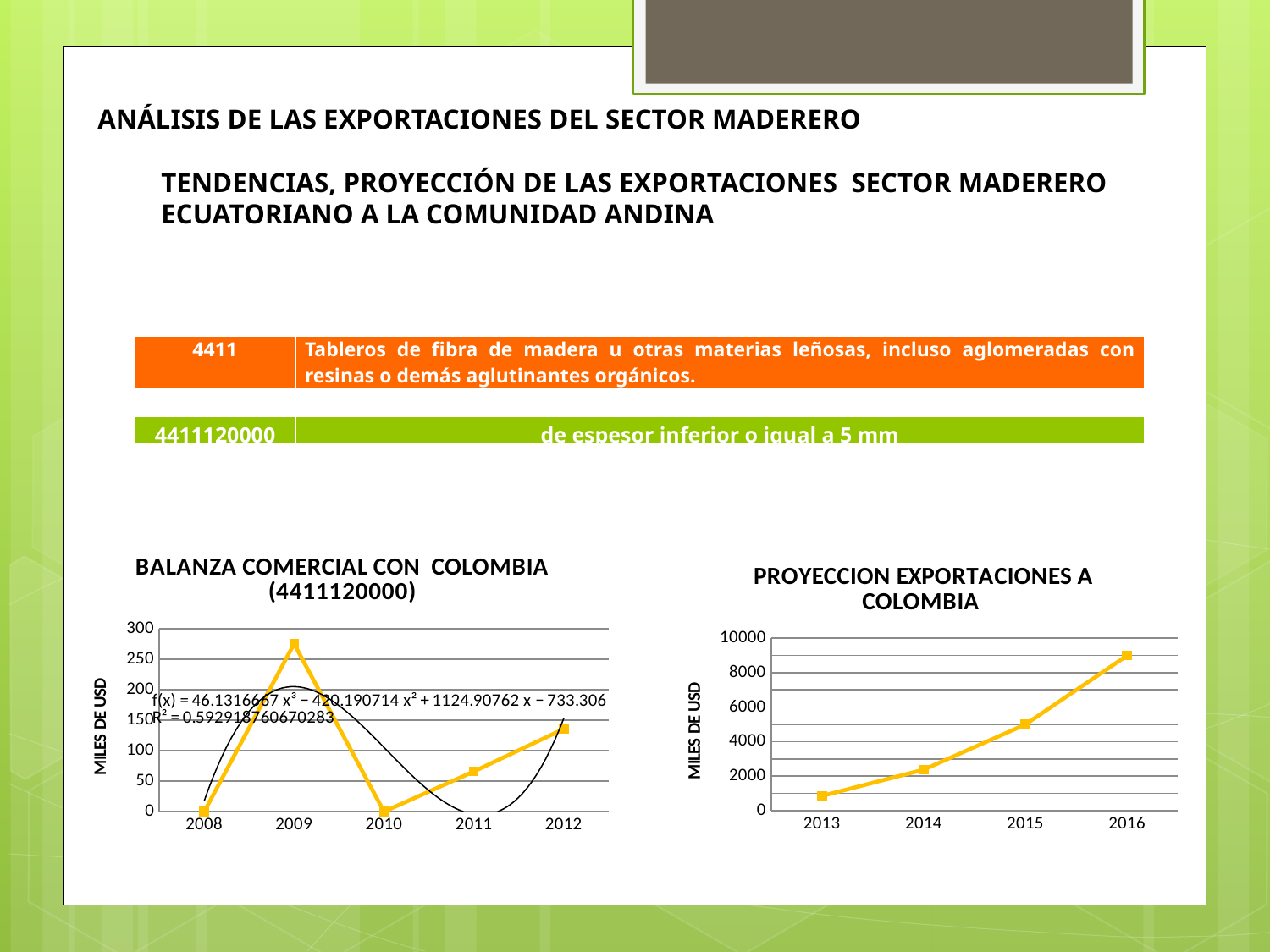
In the 'BALANZA COMERCIAL CON COLOMBIA (4411120000)' chart, how many years are shown on the x axis? 5 In the 'BALANZA COMERCIAL CON COLOMBIA (4411120000)' chart, is the value for 2009 greater or less than 250? greater In the 'PROYECCION EXPORTACIONES A COLOMBIA' chart, do the values rise or fall from 2013 to 2016? rise In the 'PROYECCION EXPORTACIONES A COLOMBIA' chart, which year has the lowest value? 2013 In the 'PROYECCION EXPORTACIONES A COLOMBIA' chart, how many years are shown on the x axis? 4 In the 'BALANZA COMERCIAL CON COLOMBIA (4411120000)' chart, which year has the highest value? 2009 What kind of chart is the 'BALANZA COMERCIAL CON COLOMBIA (4411120000)' chart? line chart What is the y-axis label of the 'PROYECCION EXPORTACIONES A COLOMBIA' chart? MILES DE USD What kind of chart is the 'PROYECCION EXPORTACIONES A COLOMBIA' chart? line chart In the 'PROYECCION EXPORTACIONES A COLOMBIA' chart, is the value for 2016 greater or less than 8000? greater In the 'PROYECCION EXPORTACIONES A COLOMBIA' chart, which year has the highest value? 2016 In the 'BALANZA COMERCIAL CON COLOMBIA (4411120000)' chart, which is larger, the value for 2011 or the value for 2012? 2012